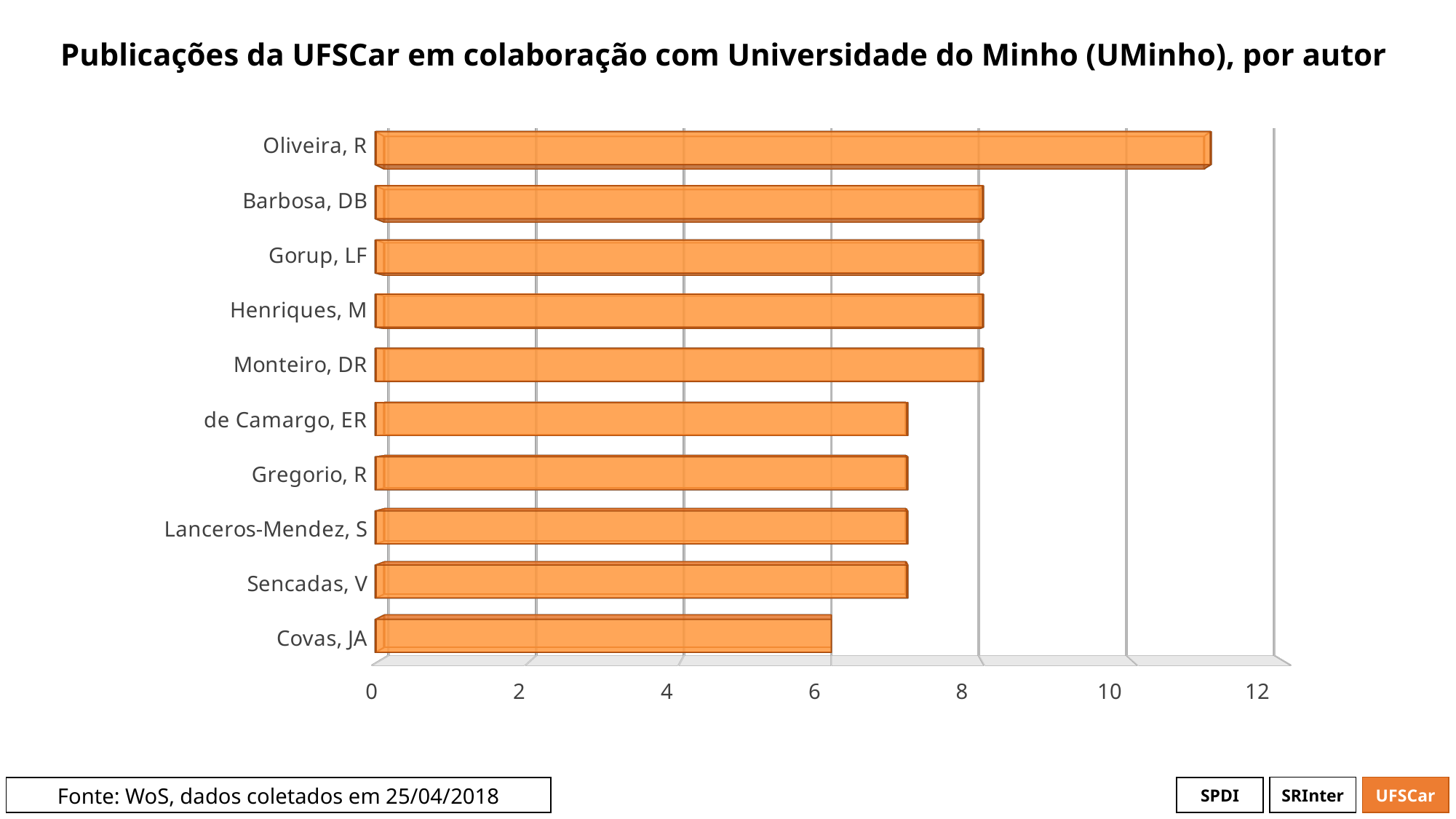
Who has more publications, Gorup, LF or Covas, JA? Gorup, LF What kind of chart is shown on the slide? bar chart Which author has the highest number of publications? Oliveira, R What is the title of the chart? Publicações da UFSCar em colaboração com Universidade do Minho (UMinho), por autor How many authors are listed on the chart? 10 Is the value for Covas, JA greater or less than 8? less Which author has the lowest number of publications? Covas, JA Is the value for Sencadas, V greater or less than 8? less Who has more publications, Oliveira, R or Barbosa, DB? Oliveira, R Is the value for Oliveira, R greater or less than 10? greater